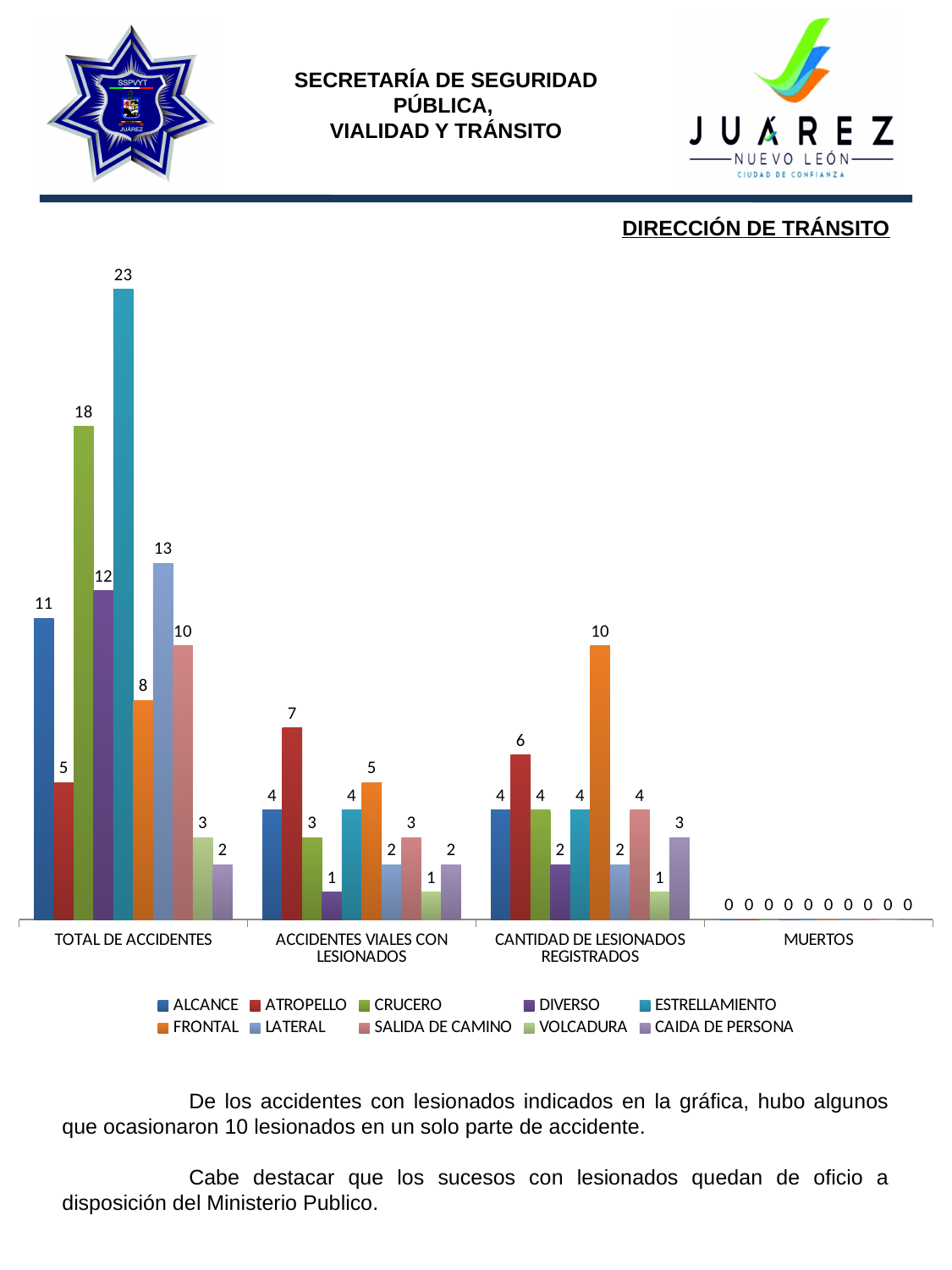
What is the value for every series in the MUERTOS category? 0 In the CANTIDAD DE LESIONADOS REGISTRADOS category, which is larger: ATROPELLO or FRONTAL? FRONTAL How many categories are shown on the x axis? 4 Which series has the highest value in the TOTAL DE ACCIDENTES category? ESTRELLAMIENTO What is the value for LATERAL in the TOTAL DE ACCIDENTES category? 13 What is the value for ATROPELLO in the ACCIDENTES VIALES CON LESIONADOS category? 7 How many series does the legend list? 10 What is the value for FRONTAL in the CANTIDAD DE LESIONADOS REGISTRADOS category? 10 What is the value for ESTRELLAMIENTO in the TOTAL DE ACCIDENTES category? 23 What is the difference between CRUCERO and ALCANCE in the TOTAL DE ACCIDENTES category? 7 What kind of chart is shown on the slide? Bar chart Which series has the lowest value in the TOTAL DE ACCIDENTES category? CAIDA DE PERSONA